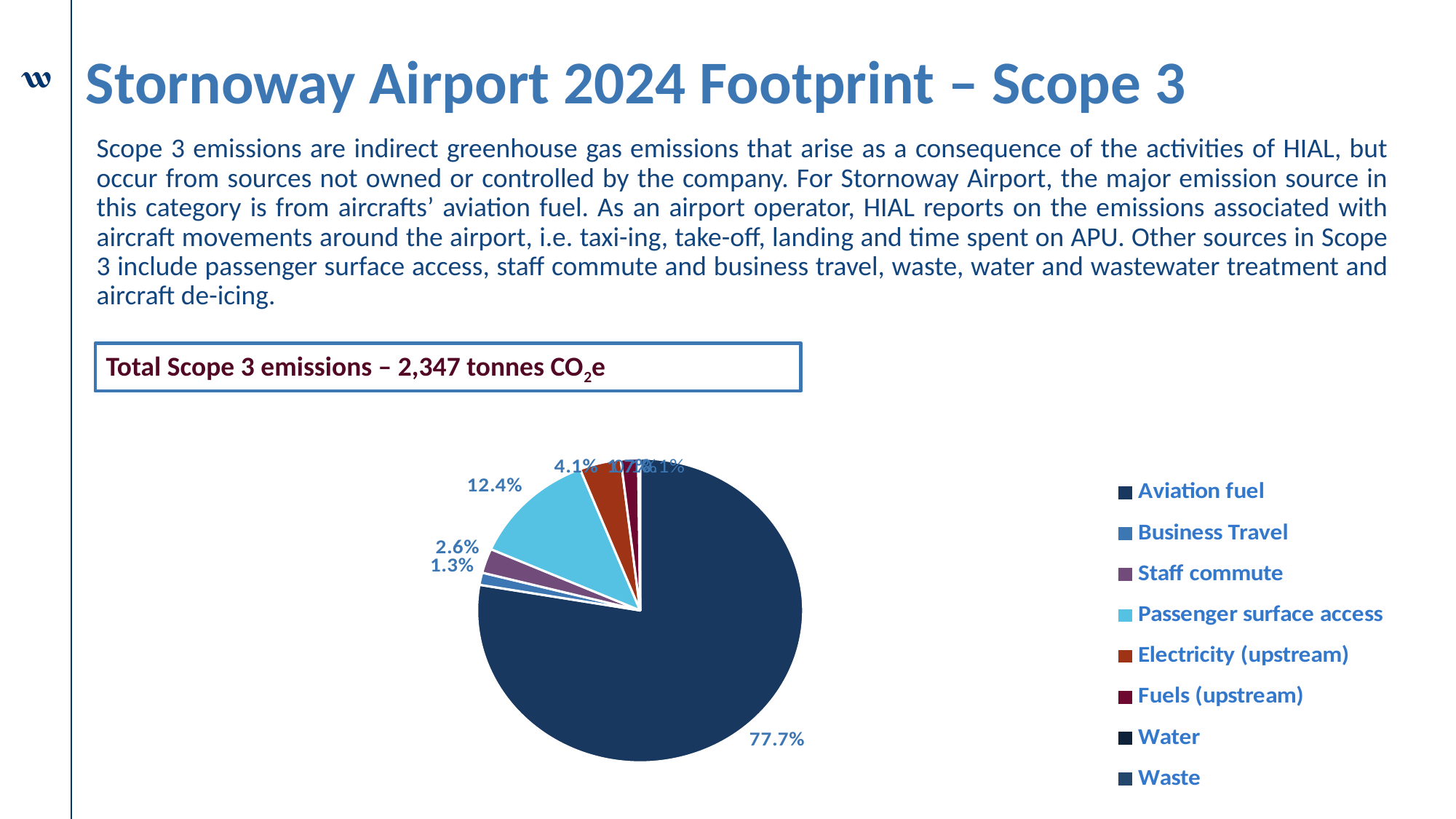
What share does Business Travel have in the pie chart? 1.3% What total Scope 3 emissions figure is stated above the pie chart? 2,347 tonnes CO2e Which slice is larger, Passenger surface access or Electricity (upstream)? Passenger surface access What colour is the Aviation fuel slice in the pie chart? Dark navy blue What percentage of the pie chart is Staff commute? 2.6% What percentage of the pie chart is Passenger surface access? 12.4% What share of Scope 3 emissions does Aviation fuel account for in the pie chart? 77.7% Which category has the largest slice of the pie chart? Aviation fuel What share does Electricity (upstream) have in the pie chart? 4.1% What is the difference in percentage points between the Aviation fuel slice and the Passenger surface access slice? 65.3 percentage points What kind of chart is shown on the slide? Pie chart How many categories does the pie chart legend list? 8